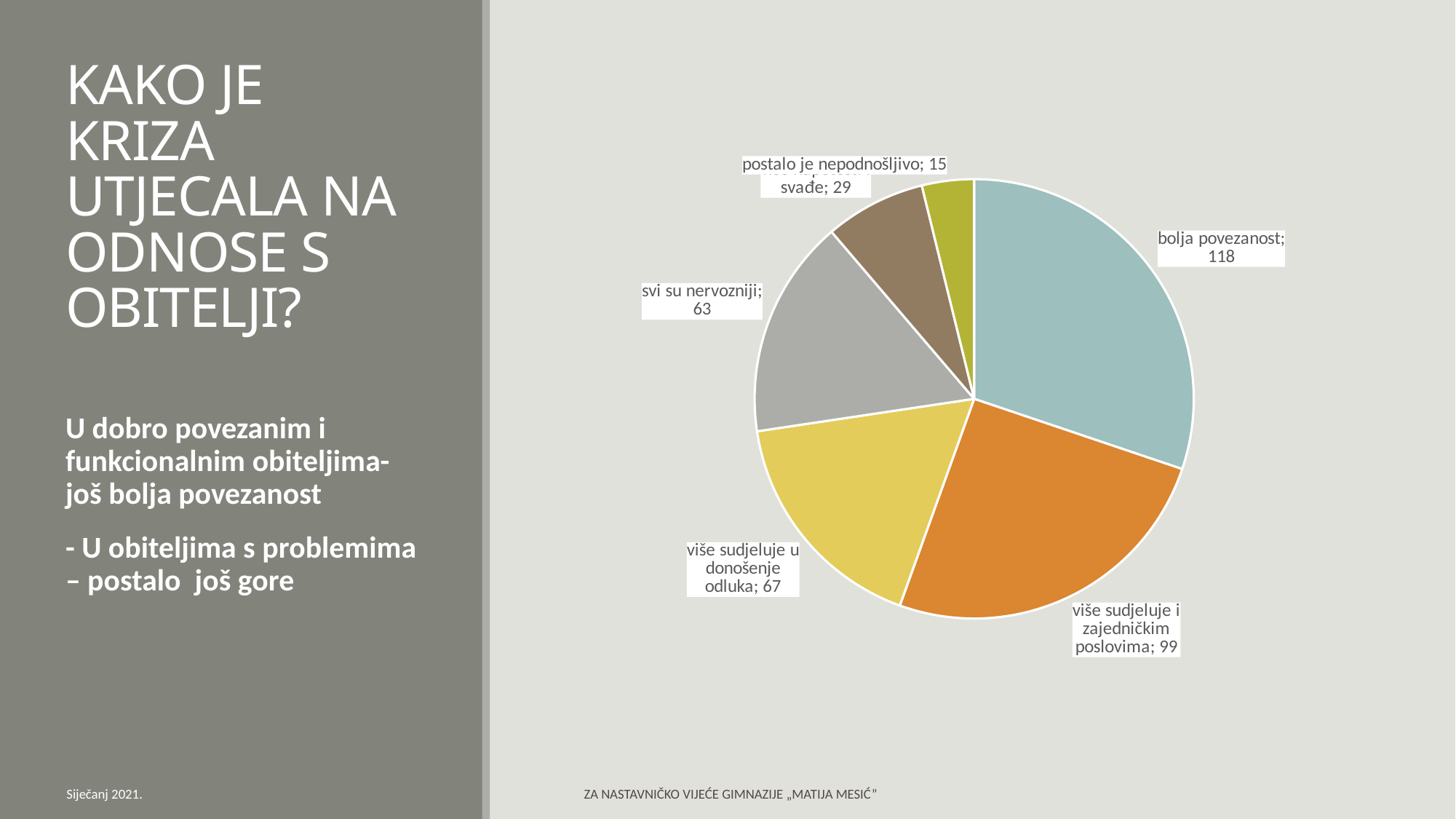
Which is larger, "više sudjeluje u donošenje odluka" or "svi su nervozniji"? više sudjeluje u donošenje odluka What is the value for "više sudjeluje i zajedničkim poslovima"? 99 Which category has the smallest slice? postalo je nepodnošljivo What is the value for "postalo je nepodnošljivo"? 15 What is the value for "svi su nervozniji"? 63 What is the difference between the values for "svi su nervozniji" and "postalo je nepodnošljivo"? 48 What kind of chart is shown on the slide? pie chart What is the value for "bolja povezanost"? 118 What is the difference between the values for "bolja povezanost" and "više sudjeluje i zajedničkim poslovima"? 19 How many slices does the pie chart have? 6 Which category has the largest slice? bolja povezanost What is the value for "više sudjeluje u donošenje odluka"? 67